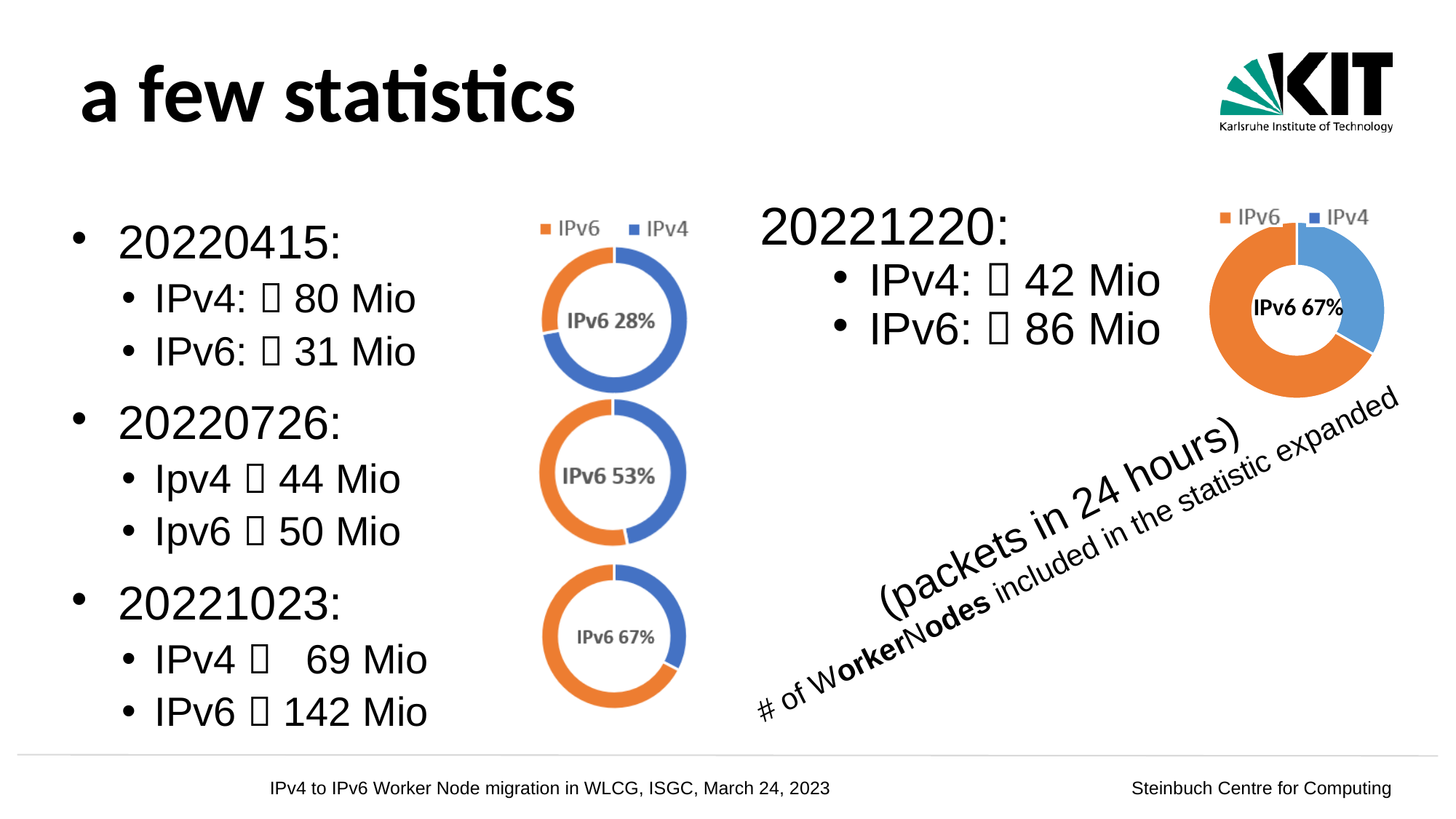
In the top donut chart of the middle column, is the IPv4 share greater or less than 50%? greater In the middle donut chart of the middle column, what share is labelled for IPv6? IPv6 53% In the donut chart at the top right, which colour represents IPv6? orange In the bottom donut chart of the middle column, what share is labelled for IPv6? IPv6 67% How many series does the legend above the middle-column donut charts list? 2 Reading the three donut charts in the middle column from top to bottom, does the IPv6 share rise or fall? rise In the donut chart at the top right of the slide, what share is labelled for IPv6? IPv6 67% In the bottom donut chart of the middle column, which segment is larger, IPv6 or IPv4? IPv6 In the donut chart at the top right, is the IPv4 share greater or less than 50%? less What kind of chart is used to show the IPv6 share in the middle column? donut chart In the top donut chart of the middle column, which segment is larger, IPv6 or IPv4? IPv4 In the top donut chart of the middle column, what share is labelled for IPv6? IPv6 28%